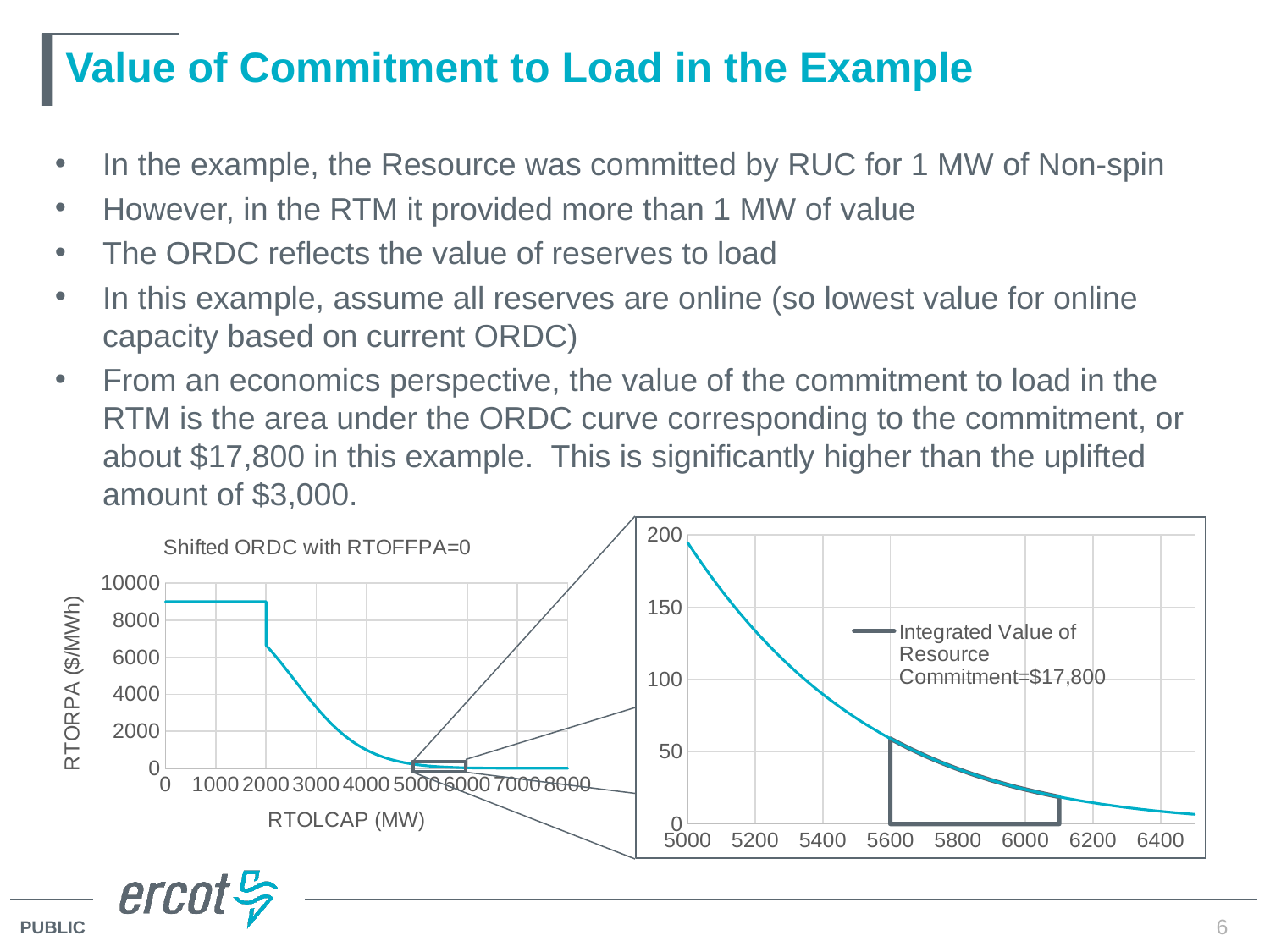
What kind of chart is the chart on the left of the slide? line chart In the chart on the left, is the RTORPA value at RTOLCAP of 0 MW greater or less than 6000? greater In the chart on the left, is the RTORPA value at RTOLCAP of 6000 MW greater or less than 2000? less In the zoomed-in chart on the right, is the value at 5400 MW greater or less than 100? less In the chart on the left, what is the label of the x axis? RTOLCAP (MW) What is the title of the chart on the left of the slide? Shifted ORDC with RTOFFPA=0 In the zoomed-in chart on the right, what integrated value of resource commitment does the legend state? $17,800 How many entries does the legend of the zoomed-in chart on the right list? 1 In the chart on the left, do the RTORPA values rise or fall as RTOLCAP increases? fall